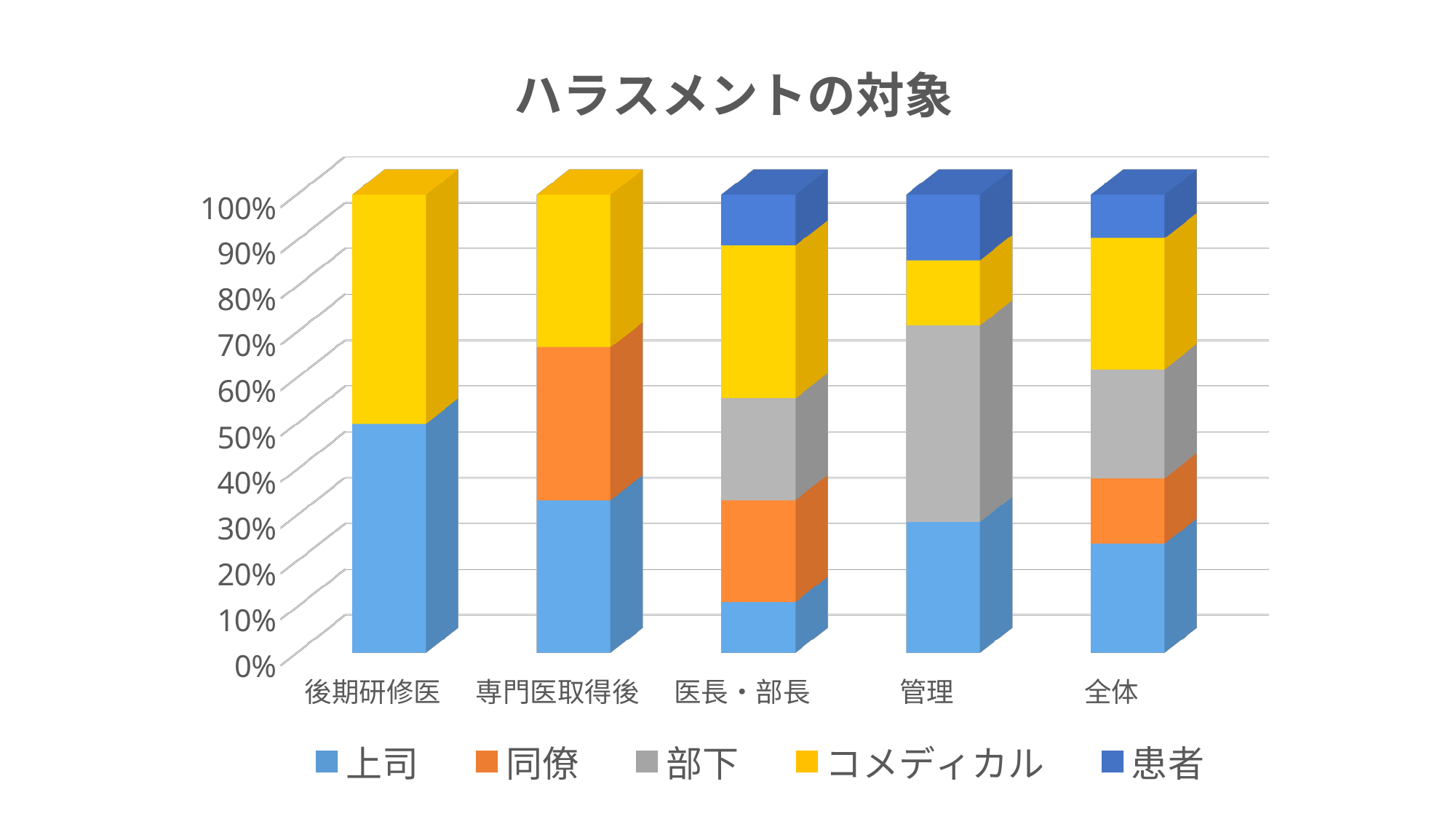
Is the 上司 share for 専門医取得後 greater or less than 40%? less Which has the larger 上司 share, 後期研修医 or 医長・部長? 後期研修医 Is the 上司 share for 後期研修医 greater or less than 40%? greater Which category has the largest 部下 share? 管理 Is the 部下 share for 管理 greater or less than 30%? greater What is the title of the chart? ハラスメントの対象 Which series is shown in orange in the legend? 同僚 Which category has the largest 上司 share? 後期研修医 How many categories are shown on the x axis of the chart? 5 What kind of chart is shown on the slide? Stacked bar chart How many series does the legend list? 5